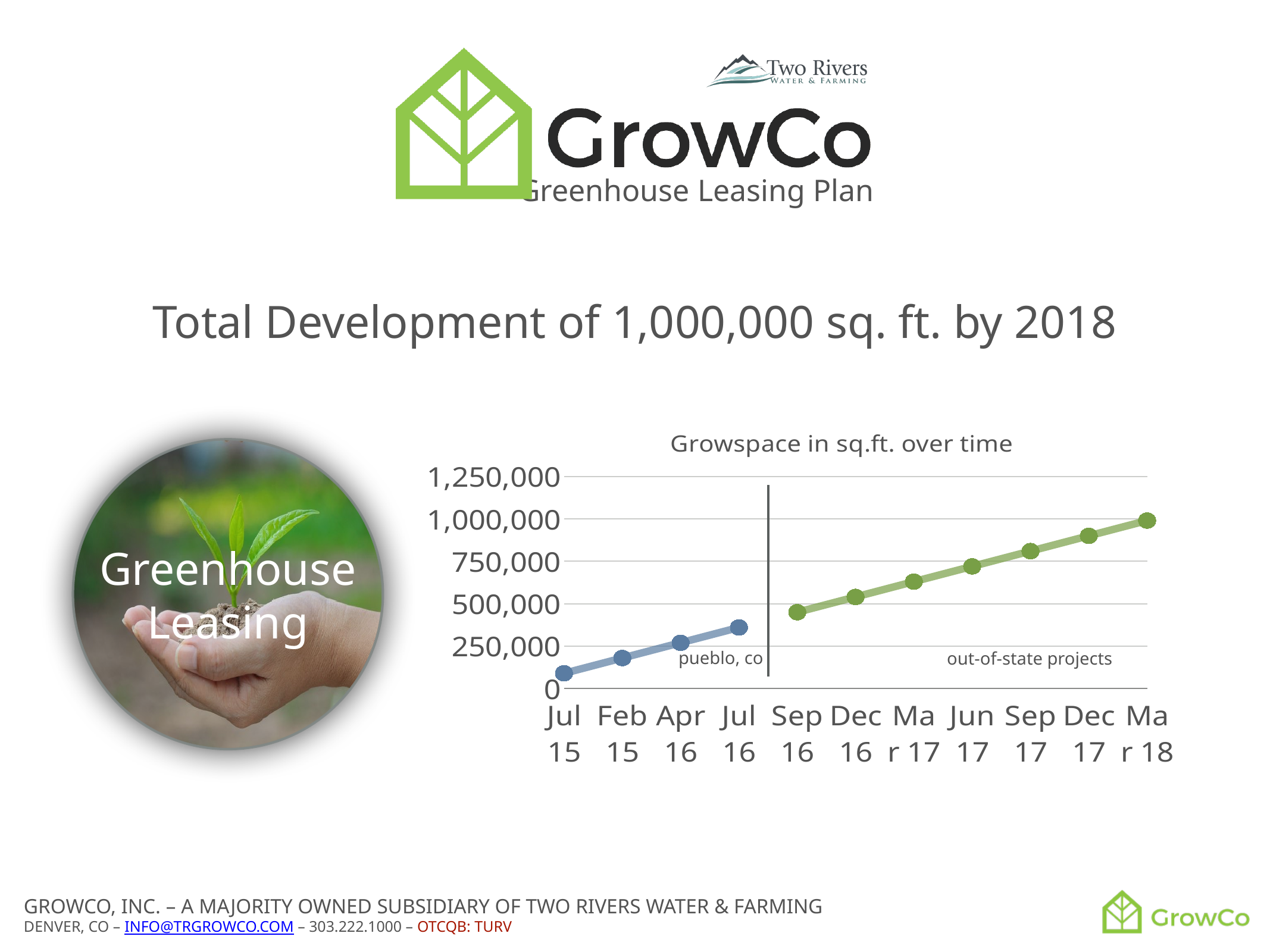
Which has the larger growspace value, Dec 17 or Apr 16? Dec 17 Which point on the x axis has the lowest growspace value? Jul 15 Is the growspace value for Jul 15 greater or less than 250,000? less Is the growspace value for Dec 17 greater or less than 750,000? greater Is the growspace value for Mar 17 greater or less than 500,000? greater Do the values rise or fall along the x axis from Jul 15 to Mar 18? rise How many data points are plotted on the chart? 11 What label is shown on the chart for the green line segment on the right side of the vertical divider? out-of-state projects Which point on the x axis has the highest growspace value? Mar 18 What is the title of the chart? Growspace in sq.ft. over time What type of chart is shown on the slide? line chart